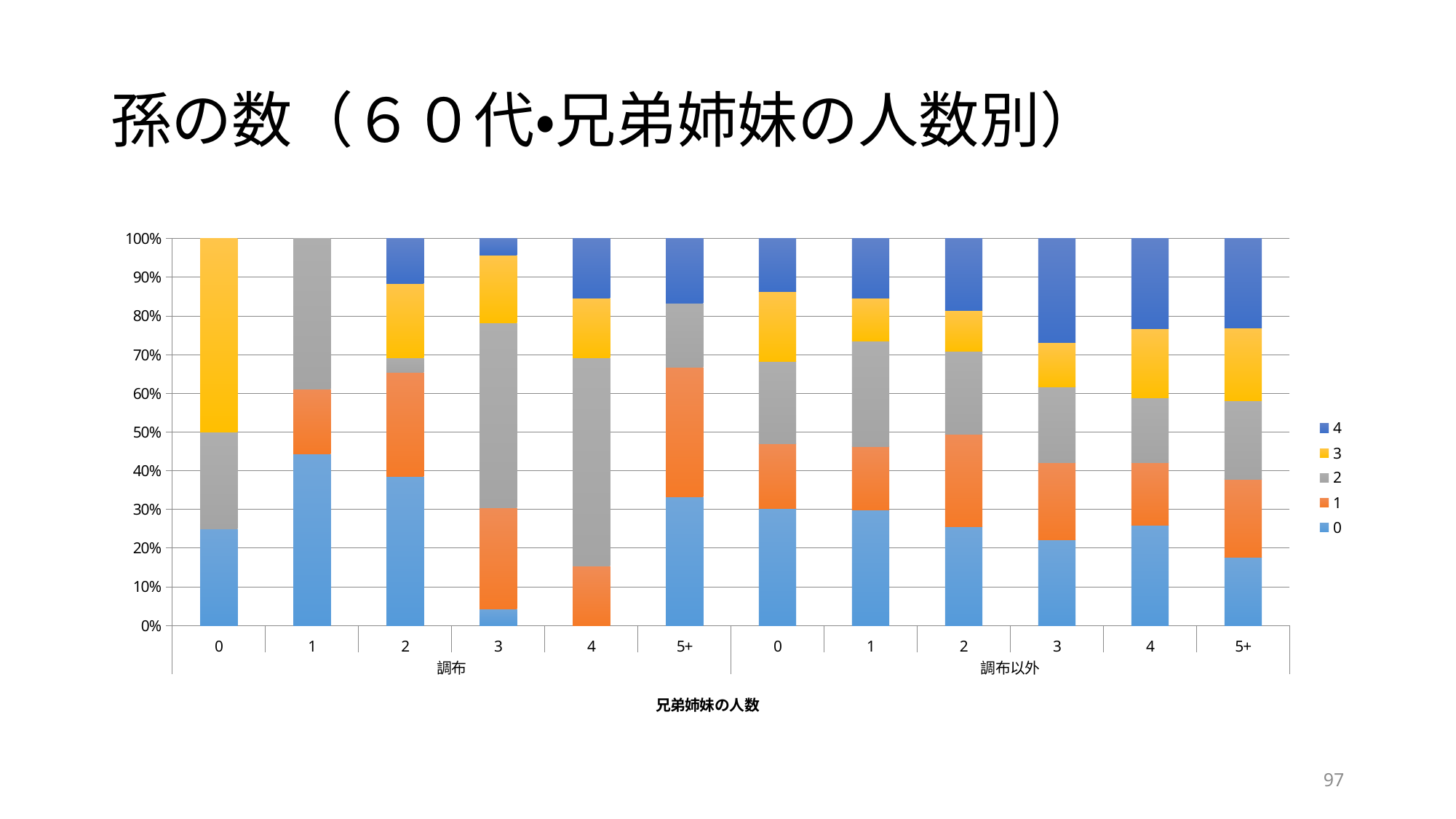
Is the value of series 0 for the 調布 1 bar greater or less than 40%? greater What kind of chart is shown on the slide? Stacked bar chart What is the title of the chart on the slide? 孫の数（６０代•兄弟姉妹の人数別） How many series does the legend list? 5 What is the x-axis title of the chart? 兄弟姉妹の人数 What is the total of the stacked bar for 調布 0? 100% Which bar has the larger value for series 0: 調布 5+ or 調布以外 5+? 調布 5+ Which bar has the larger value for series 0: 調布 1 or 調布 0? 調布 1 Is the value of series 0 for the 調布 3 bar greater or less than 10%? less Is the value of series 0 for the 調布 0 bar greater or less than 30%? less How many bars are plotted in the chart? 12